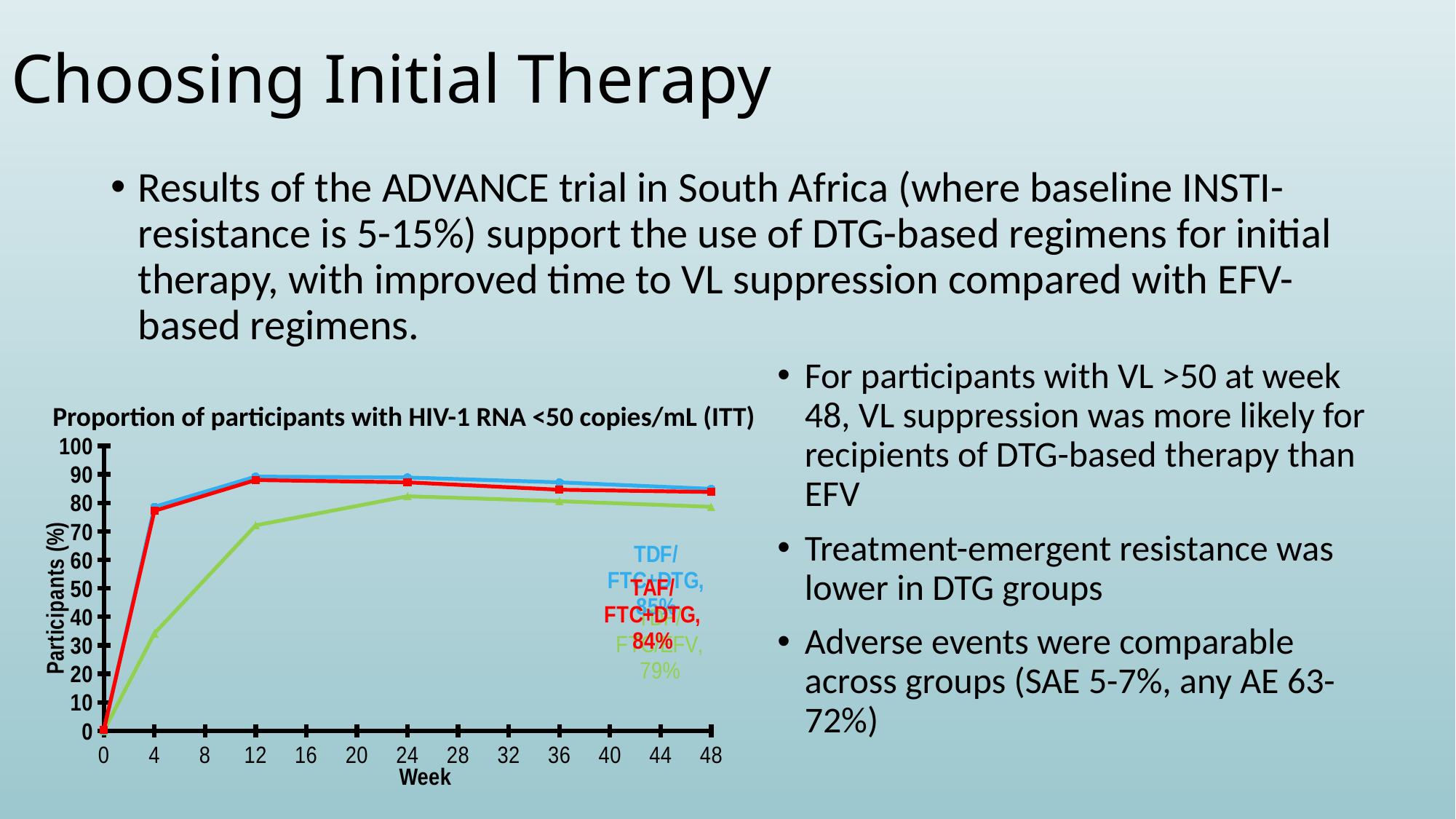
Do the lines rise or fall between week 0 and week 12? rise Is the value for the TAF/FTC+DTG arm at week 4 greater or less than 70? greater What is the difference between the week 48 values of the TAF/FTC+DTG arm and the TDF/FTC/EFV arm? 5 percentage points What kind of chart is shown on the slide? line chart Which arm has the lowest proportion of participants with HIV-1 RNA <50 copies/mL at week 48? TDF/FTC/EFV What is the week 48 value labelled for the TDF/FTC/EFV arm? 79% What is the title of the chart? Proportion of participants with HIV-1 RNA <50 copies/mL (ITT) What is the week 48 value labelled for the TAF/FTC+DTG arm? 84% What is the label of the x axis of the chart? Week At week 12, which is higher: the TDF/FTC/EFV line or the TAF/FTC+DTG line? TAF/FTC+DTG Is the value for the TDF/FTC/EFV arm at week 4 greater or less than 50? less How many series (treatment arms) are plotted in the chart? 3